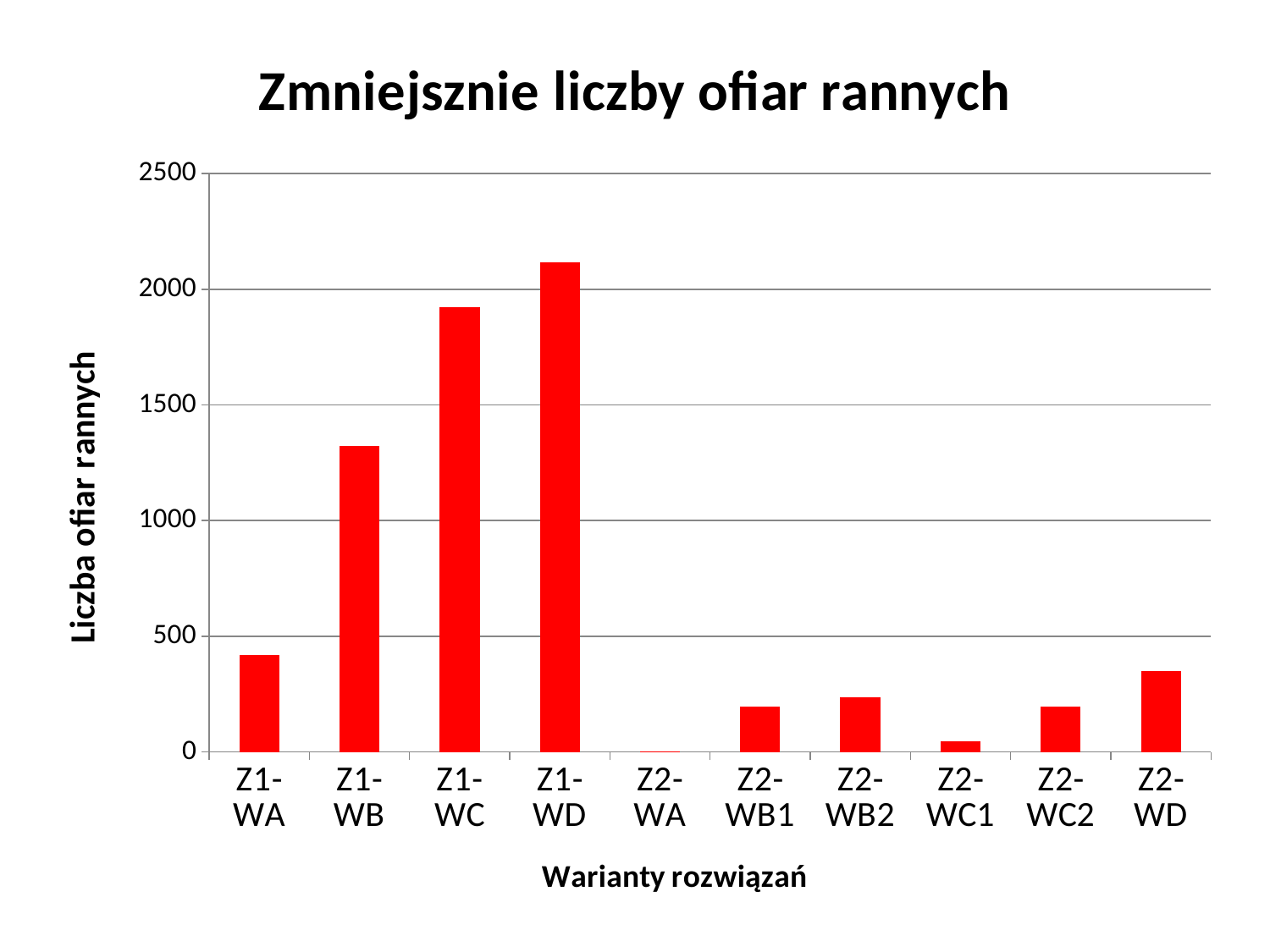
Is the value for Z1-WB greater or less than 1000? greater Is the value for Z1-WD greater or less than 2000? greater What is the label of the x axis? Warianty rozwiązań What is the title of the chart? Zmniejsznie liczby ofiar rannych Which variant has the lowest number of injured victims? Z2-WA Which variant has the highest number of injured victims? Z1-WD How many variants (categories) are shown on the x axis? 10 Is the value for Z1-WC greater or less than 2000? less Which is larger, the value for Z1-WC or the value for Z1-WB? Z1-WC Which is larger, the value for Z2-WD or the value for Z2-WC1? Z2-WD What kind of chart is shown on the slide? bar chart